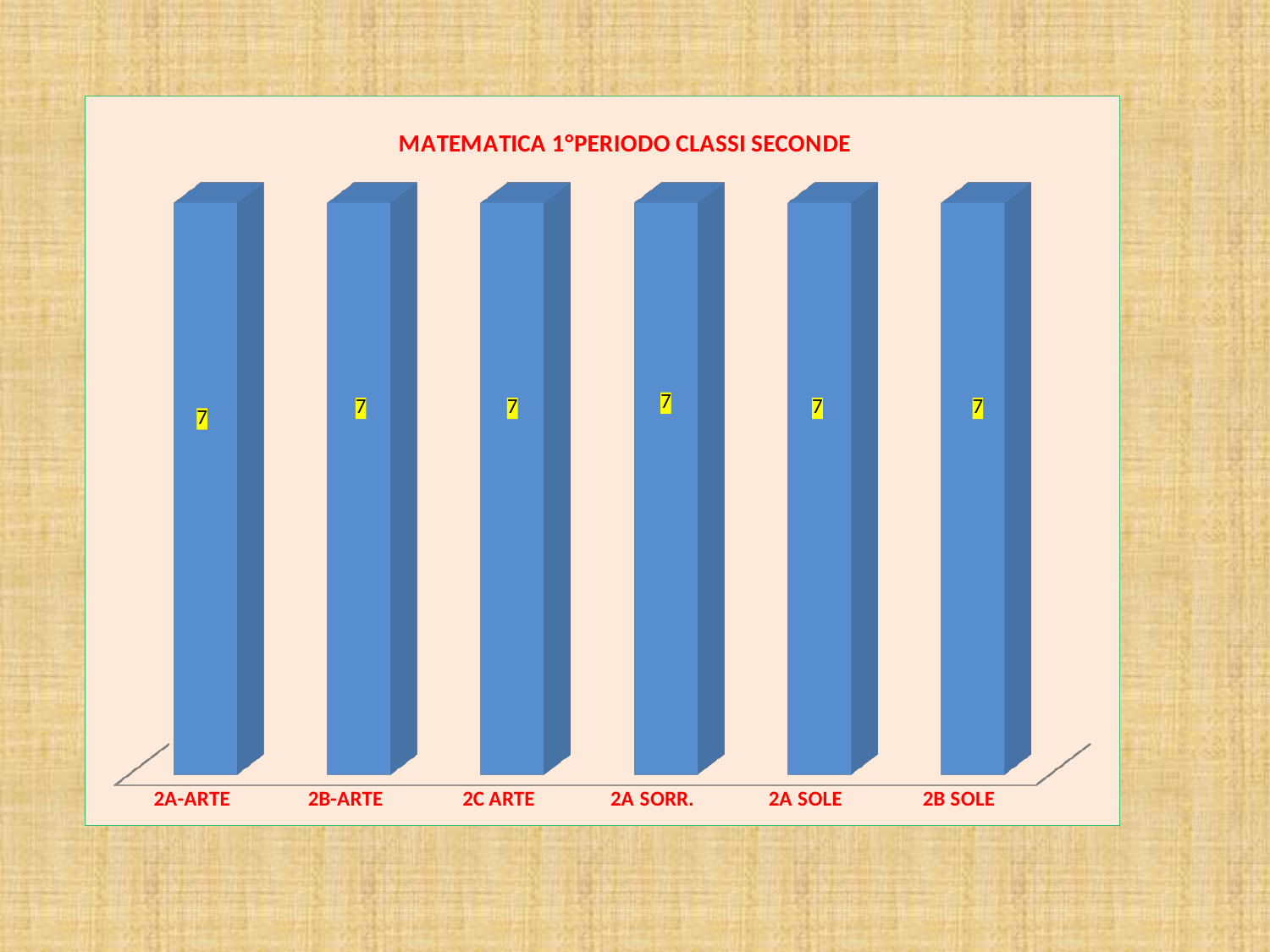
What is the value for 2A-ARTE? 7 What is the value for 2B-ARTE? 7 What is the value for 2C ARTE? 7 What is the value for 2A SOLE? 7 What is the value for 2A SORR.? 7 What is the label of the fourth category from the left? 2A SORR. Do the values rise, fall, or stay the same across the categories from left to right? Stay the same What kind of chart is shown on the slide? Bar chart How many categories are shown on the x axis? 6 What is the title of the chart? MATEMATICA 1°PERIODO CLASSI SECONDE What is the difference between the values for 2A-ARTE and 2B SOLE? 0 What is the value for 2B SOLE? 7